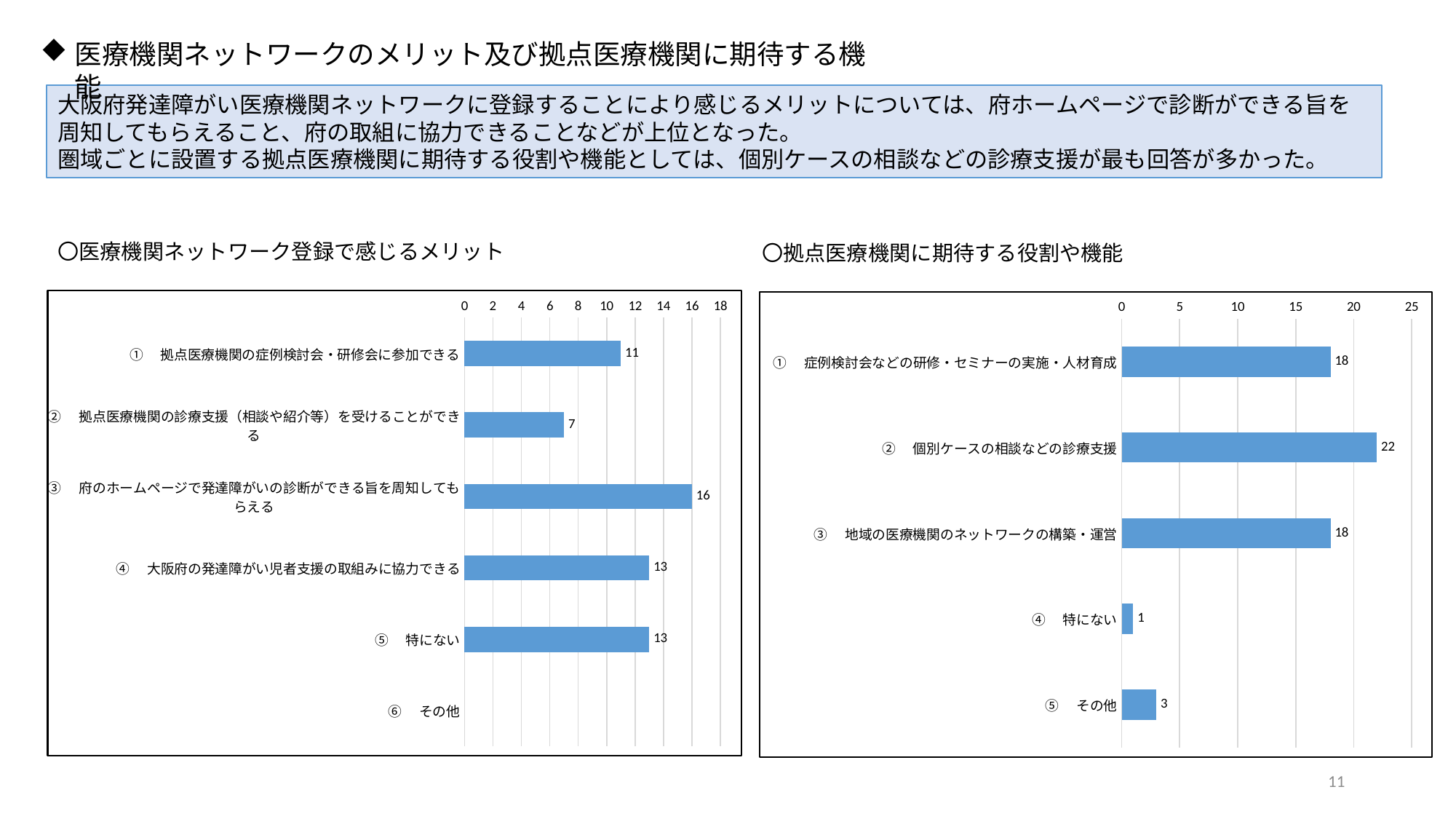
In the left chart (医療機関ネットワーク登録で感じるメリット), what is the value for ② 拠点医療機関の診療支援（相談や紹介等）を受けることができる? 7 In the right chart (拠点医療機関に期待する役割や機能), what is the value for ② 個別ケースの相談などの診療支援? 22 In the right chart (拠点医療機関に期待する役割や機能), what is the difference between ② 個別ケースの相談などの診療支援 and ⑤ その他? 19 In the right chart (拠点医療機関に期待する役割や機能), which is larger: ② 個別ケースの相談などの診療支援 or ③ 地域の医療機関のネットワークの構築・運営? ② 個別ケースの相談などの診療支援 In the left chart (医療機関ネットワーク登録で感じるメリット), what is the value for ③ 府のホームページで発達障がいの診断ができる旨を周知してもらえる? 16 In the left chart (医療機関ネットワーク登録で感じるメリット), how many categories are listed on the axis? 6 In the right chart (拠点医療機関に期待する役割や機能), which category has the lowest value? ④ 特にない What type of chart is the left chart (医療機関ネットワーク登録で感じるメリット)? Bar chart In the right chart (拠点医療機関に期待する役割や機能), how many categories are listed on the axis? 5 In the left chart (医療機関ネットワーク登録で感じるメリット), which category has the highest value? ③ 府のホームページで発達障がいの診断ができる旨を周知してもらえる In the left chart (医療機関ネットワーク登録で感じるメリット), what is the difference between ① 拠点医療機関の症例検討会・研修会に参加できる and ② 拠点医療機関の診療支援（相談や紹介等）を受けることができる? 4 In the right chart (拠点医療機関に期待する役割や機能), what is the value for ④ 特にない? 1